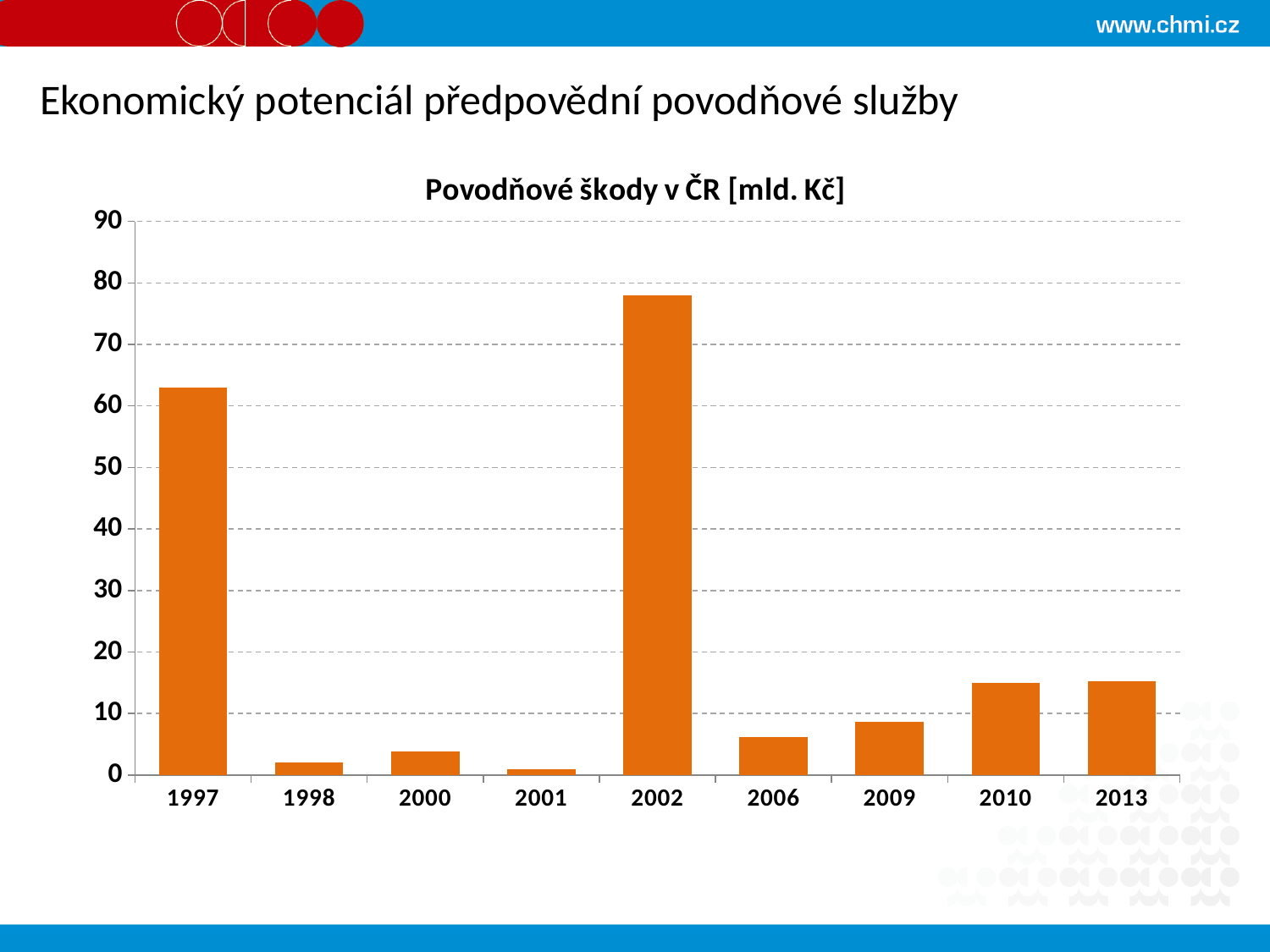
What type of chart is shown on the slide? bar chart How many years are shown on the x axis of the chart? 9 What is the highest value shown on the y axis of the chart? 90 Which year has the larger value, 2006 or 2010? 2010 What is the title of the chart? Povodňové škody v ČR [mld. Kč] Is the value for 2009 greater or less than 10? less Is the value for 2002 greater or less than 70? greater Is the value for 2010 greater or less than 20? less Which year has the larger value, 1997 or 2002? 2002 Which year has the highest flood damage value in the chart? 2002 Which year has the lowest flood damage value in the chart? 2001